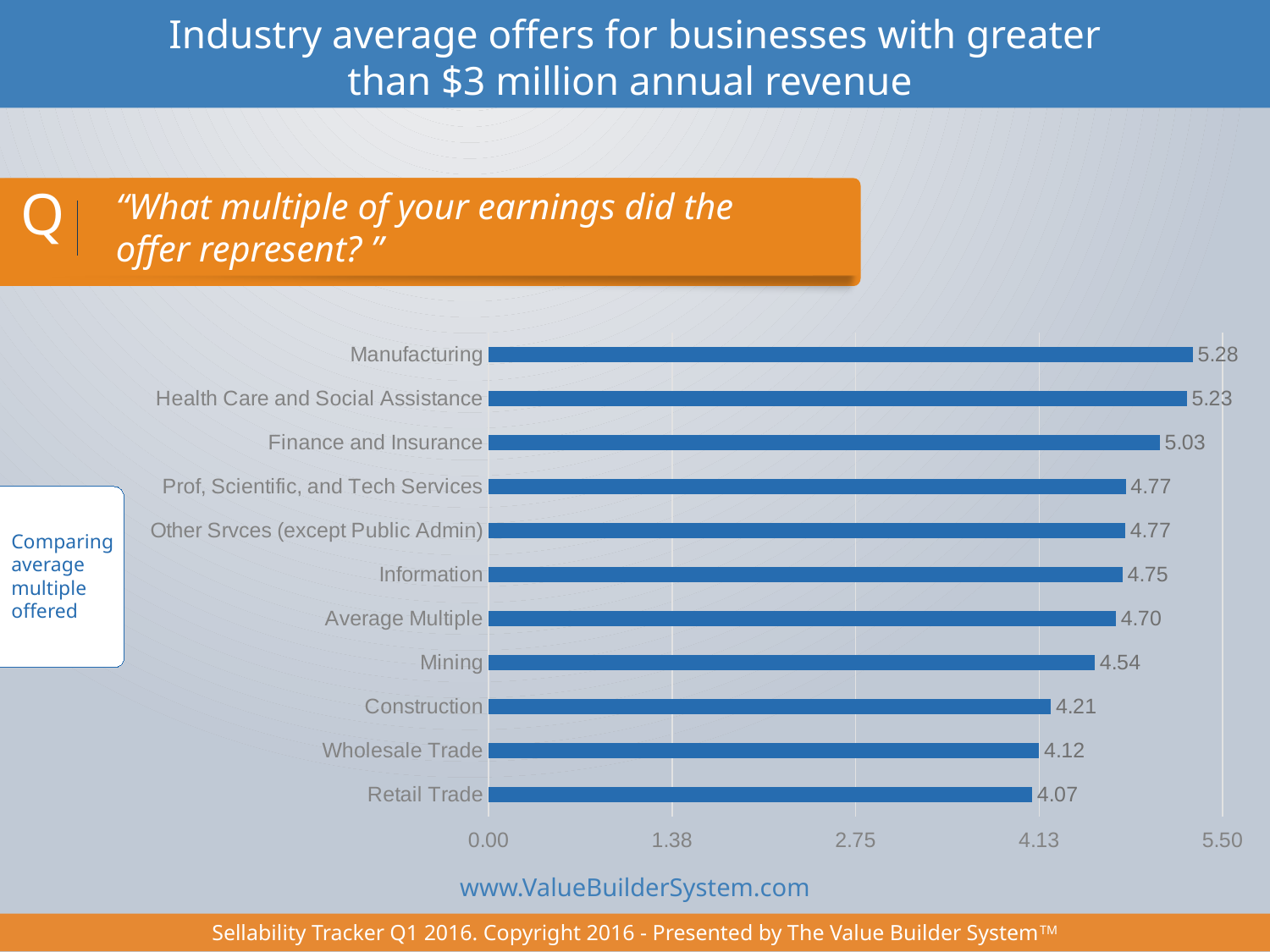
Which category has the highest average multiple? Manufacturing What is the value shown for Health Care and Social Assistance? 5.23 Which is larger, the value for Information or the value for Wholesale Trade? Information What is the value shown for the Average Multiple bar? 4.70 What is the difference between the values for Finance and Insurance and Construction? 0.82 What kind of chart is shown on the slide? Bar chart Which category has the lowest average multiple? Retail Trade What is the value shown for Mining? 4.54 What is the difference between the values for Manufacturing and Retail Trade? 1.21 What is the average multiple offered for Manufacturing? 5.28 What is the value shown for Retail Trade? 4.07 How many bars are shown in the chart? 11